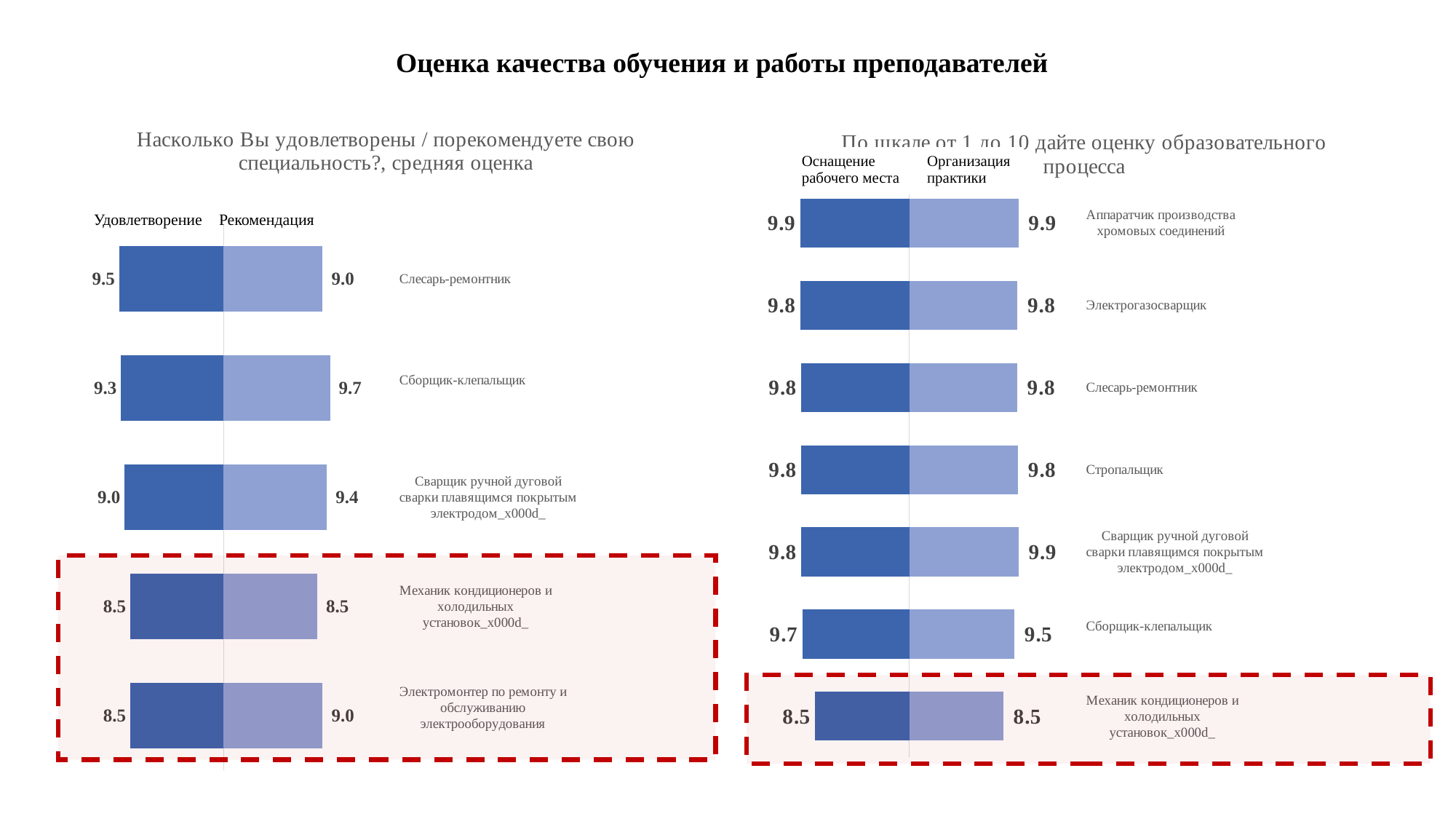
In the right chart (По шкале от 1 до 10 дайте оценку образовательного процесса), what is the Организация практики value for Сборщик-клепальщик? 9.5 In the left chart (Насколько Вы удовлетворены / порекомендуете свою специальность?), what is the difference between the Рекомендация and Удовлетворение values for Электромонтер по ремонту и обслуживанию электрооборудования? 0.5 In the right chart (По шкале от 1 до 10 дайте оценку образовательного процесса), which category has the highest Оснащение рабочего места value? Аппаратчик производства хромовых соединений In the left chart (Насколько Вы удовлетворены / порекомендуете свою специальность?), what is the Удовлетворение value for Слесарь-ремонтник? 9.5 In the left chart (Насколько Вы удовлетворены / порекомендуете свою специальность?), how many series does the legend list? 2 In the left chart (Насколько Вы удовлетворены / порекомендуете свою специальность?), which category has the highest Удовлетворение value? Слесарь-ремонтник In the right chart (По шкале от 1 до 10 дайте оценку образовательного процесса), is the Оснащение рабочего места value for Сборщик-клепальщик larger or smaller than its Организация практики value? larger In the left chart (Насколько Вы удовлетворены / порекомендуете свою специальность?), how many categories are shown? 5 What kind of chart is the left chart (Насколько Вы удовлетворены / порекомендуете свою специальность?)? bar chart In the right chart (По шкале от 1 до 10 дайте оценку образовательного процесса), how many categories are shown? 7 In the right chart (По шкале от 1 до 10 дайте оценку образовательного процесса), which category has the lowest Оснащение рабочего места value? Механик кондиционеров и холодильных установок In the left chart (Насколько Вы удовлетворены / порекомендуете свою специальность?), what is the Рекомендация value for Сборщик-клепальщик? 9.7